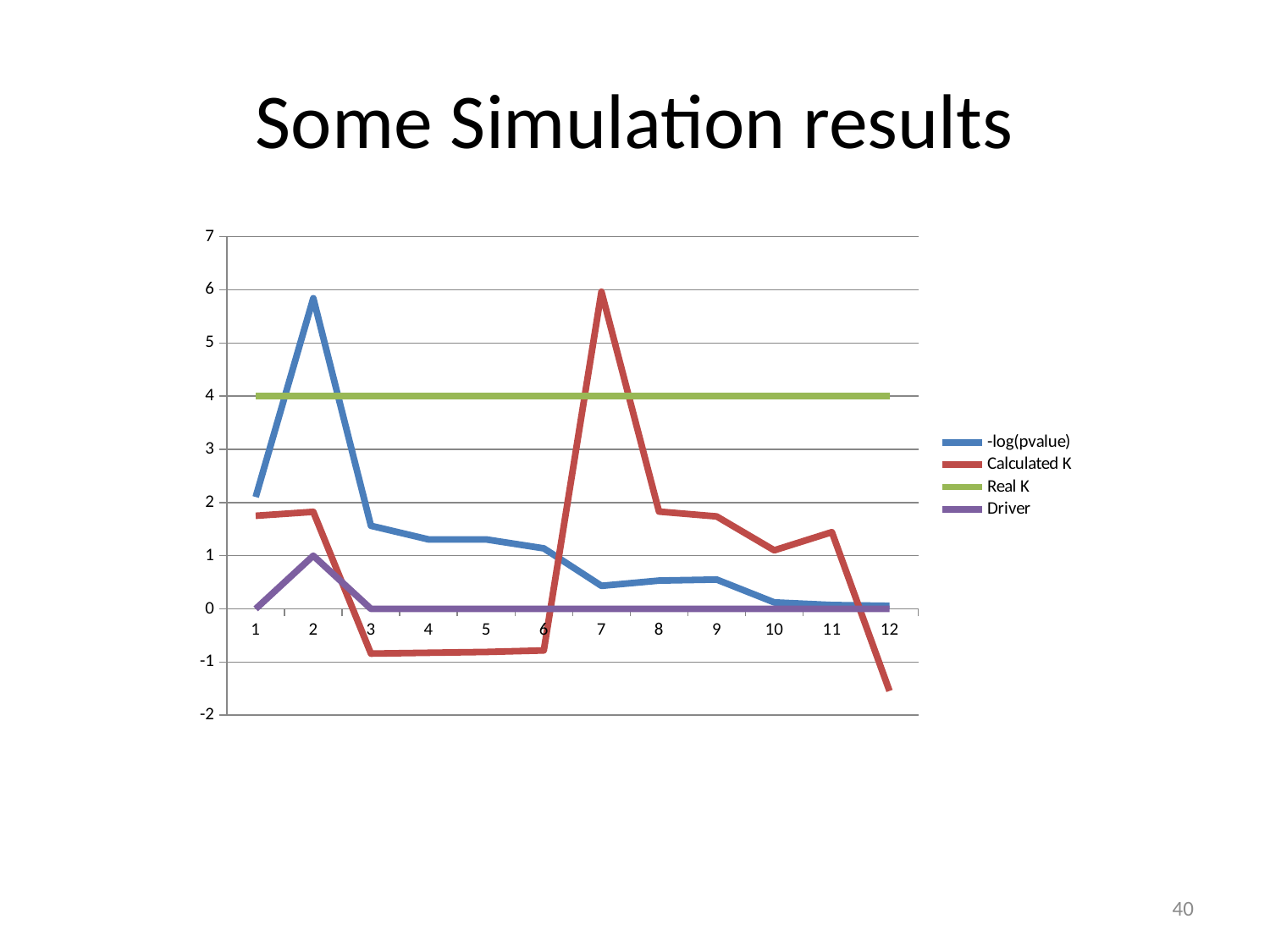
What is the value of Driver at point 2? 1 Is the value of Calculated K at point 4 greater or less than 0? less At which x-axis point is Calculated K highest? 7 At which x-axis point is -log(pvalue) highest? 2 How many points are there along the x axis? 12 Is the value of -log(pvalue) at point 2 greater or less than 5? greater What kind of chart is shown on the slide? line chart What is the value of Driver at point 8? 0 At point 7, which is larger, Calculated K or Real K? Calculated K What is the value of Real K at point 5? 4 How many series does the legend list? 4 At which x-axis point is Calculated K lowest? 12